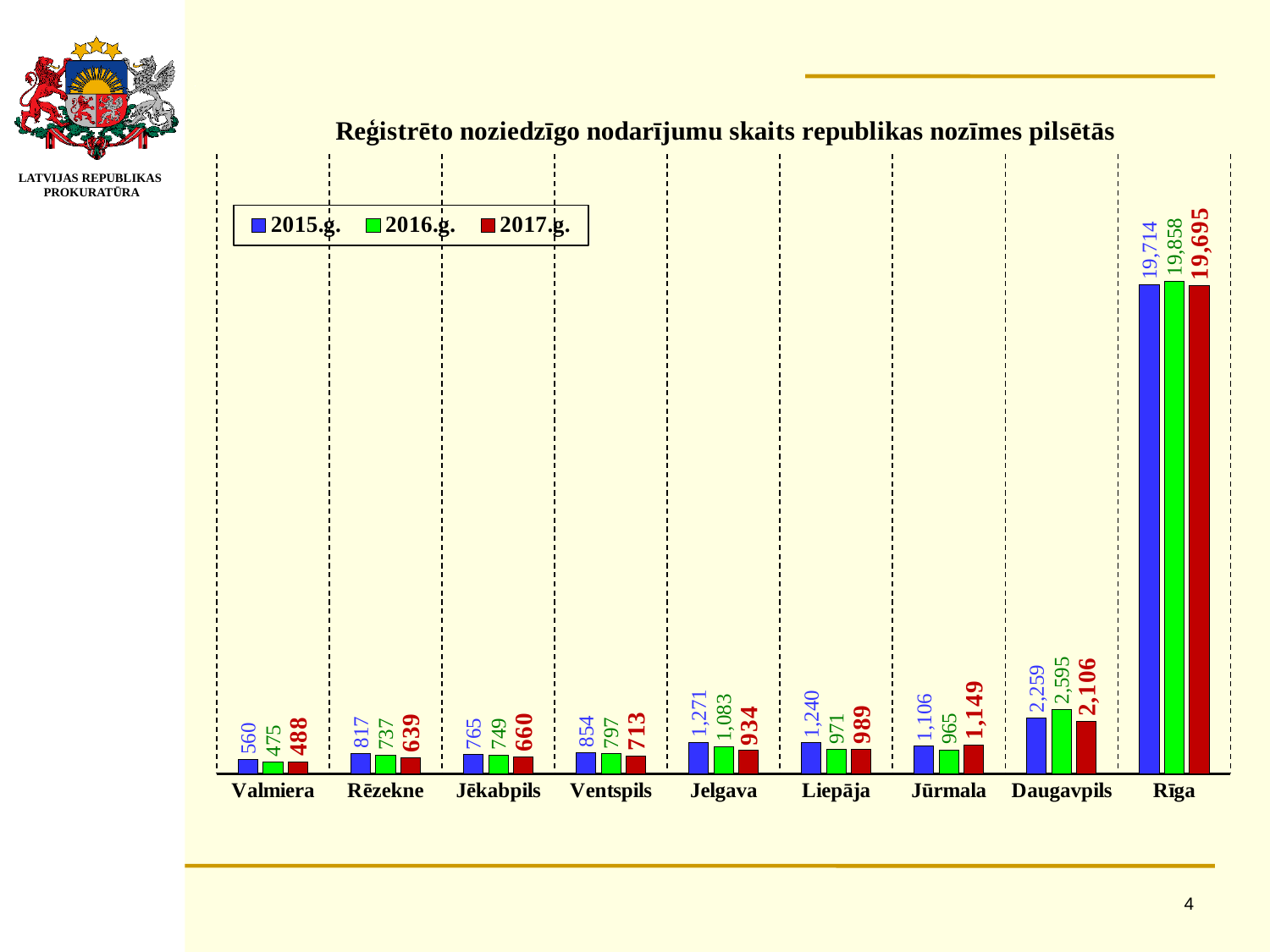
How many cities are shown on the x axis? 9 What is the value for Daugavpils in 2016.g.? 2,595 What is the value for Rīga in 2017.g.? 19,695 What is the difference between the 2015.g. and 2017.g. values for Jelgava? 337 Which city has the lowest value in 2016.g.? Valmiera What is the value for Jelgava in 2015.g.? 1,271 What kind of chart is this? bar chart How many series does the legend list? 3 Which is larger for Jūrmala: the 2016.g. value or the 2017.g. value? 2017.g. Which city has the highest value in 2017.g.? Rīga What colour represents 2016.g. in the legend? green Do the values for Ventspils rise or fall from 2015.g. to 2017.g.? fall